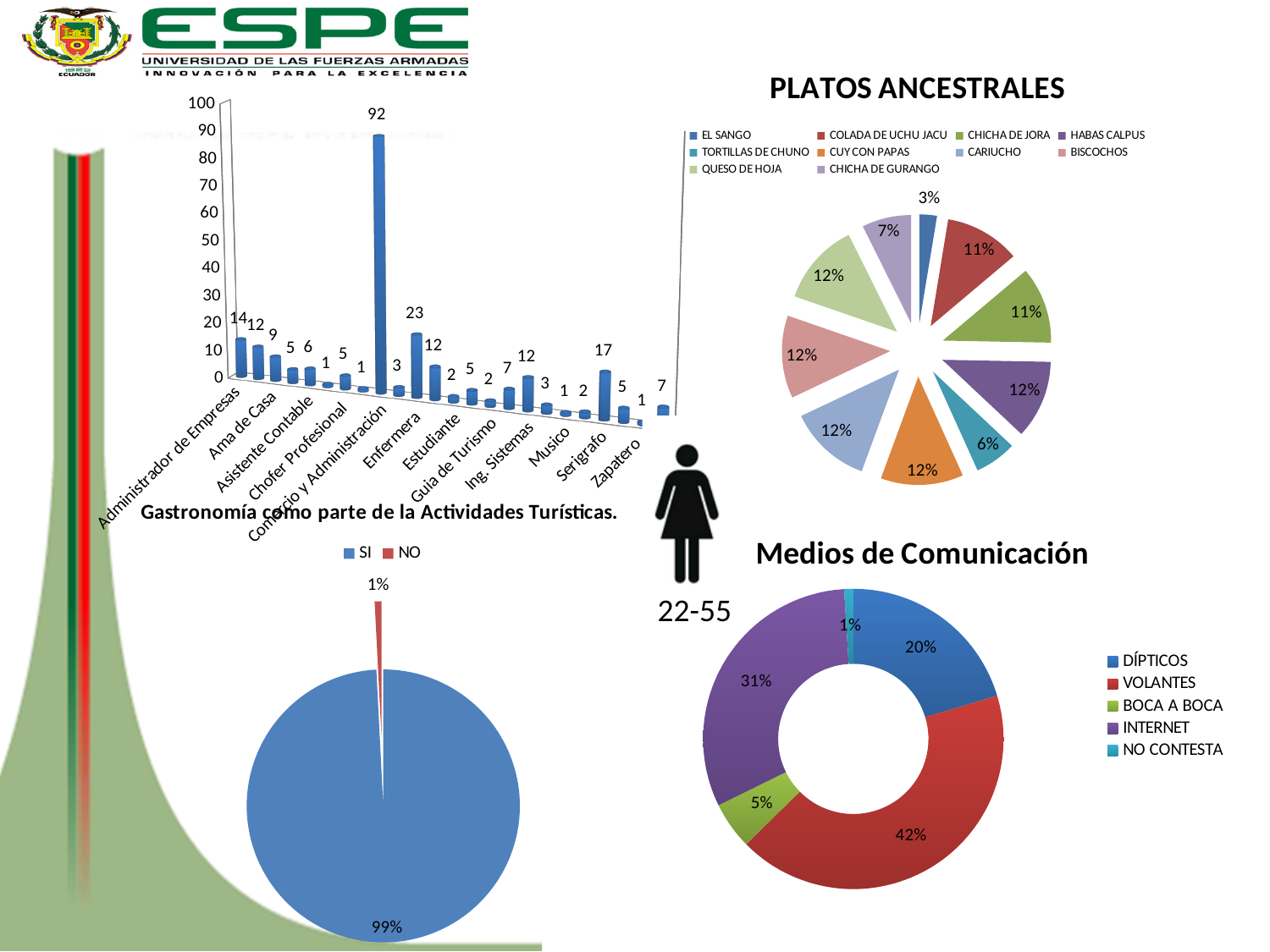
In the bar chart at the top left of the slide, what is the highest value shown? 92 In the 'Medios de Comunicación' chart, what percentage is shown for VOLANTES? 42% In the 'Medios de Comunicación' chart, which category has the smallest share? NO CONTESTA In the 'Gastronomía como parte de la Actividades Turísticas' chart, what percentage answered SI? 99% In the 'PLATOS ANCESTRALES' chart, what percentage is shown for EL SANGO? 3% In the 'PLATOS ANCESTRALES' chart, what percentage is shown for TORTILLAS DE CHUNO? 6% How many categories does the legend of the 'Medios de Comunicación' chart list? 5 In the 'Medios de Comunicación' chart, what percentage is shown for INTERNET? 31% In the 'Gastronomía como parte de la Actividades Turísticas' chart, which is larger, SI or NO? SI In the 'Medios de Comunicación' chart, what is the difference in percentage points between VOLANTES and DÍPTICOS? 22 How many entries does the legend of the 'PLATOS ANCESTRALES' chart list? 10 What kind of chart is the 'Medios de Comunicación' chart? Doughnut chart